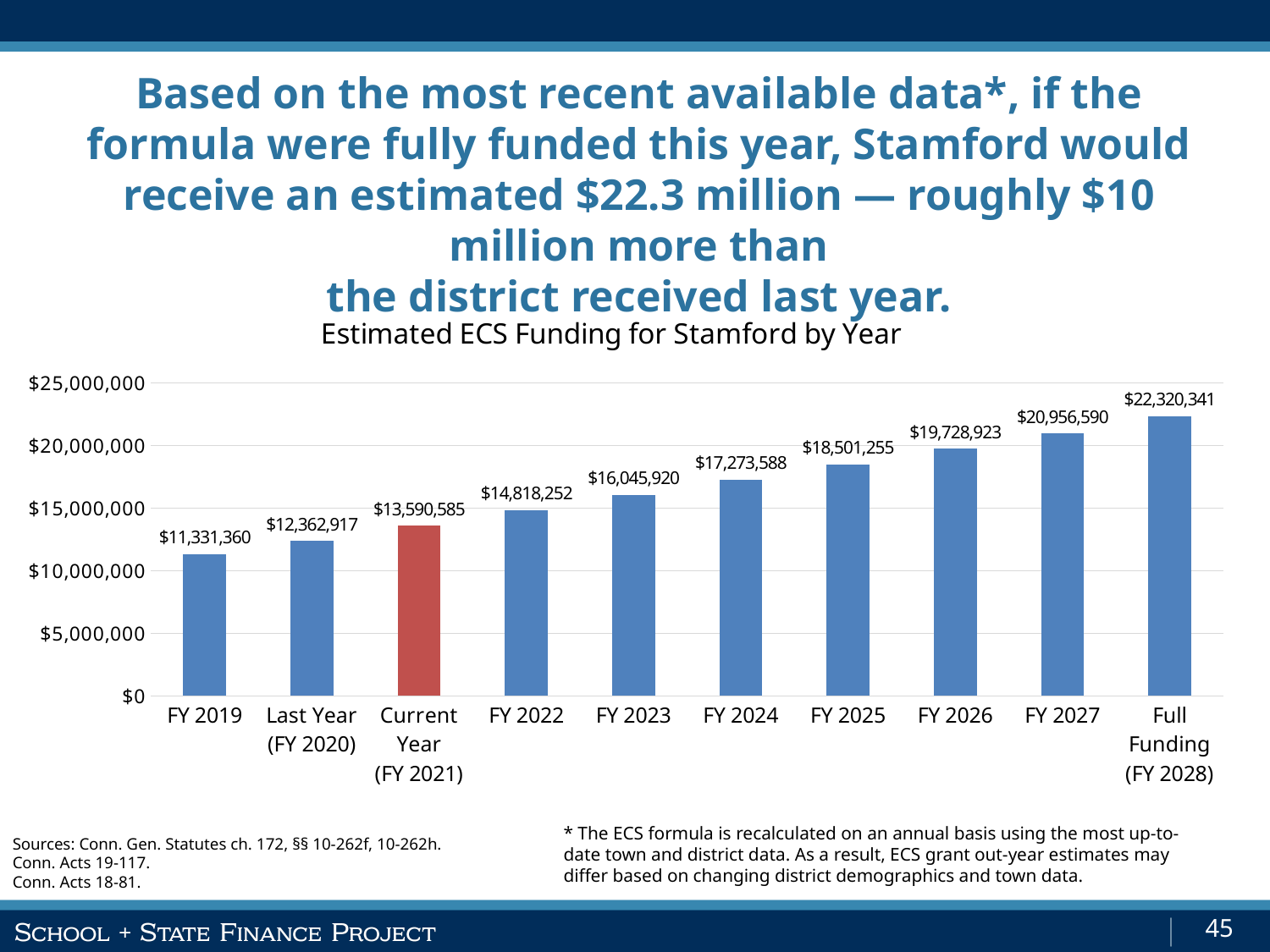
How much more is the Full Funding (FY 2028) amount than the Last Year (FY 2020) amount? $9,957,424 What is the estimated ECS funding for Stamford in FY 2019? $11,331,360 Which year has the highest estimated ECS funding for Stamford? Full Funding (FY 2028) What is the estimated ECS funding for Stamford at Full Funding (FY 2028)? $22,320,341 Do the estimated ECS funding values rise or fall from FY 2019 to Full Funding (FY 2028)? Rise How many years (bars) are shown in the chart? 10 Which year has the lowest estimated ECS funding for Stamford? FY 2019 What is the estimated ECS funding for Stamford in FY 2025? $18,501,255 What type of chart is used to show Estimated ECS Funding for Stamford by Year? Bar chart Is the estimated ECS funding for FY 2024 greater or less than $15,000,000? greater What is the difference between the Current Year (FY 2021) and Last Year (FY 2020) estimated ECS funding? $1,227,668 What is the estimated ECS funding for Stamford in the Current Year (FY 2021)? $13,590,585